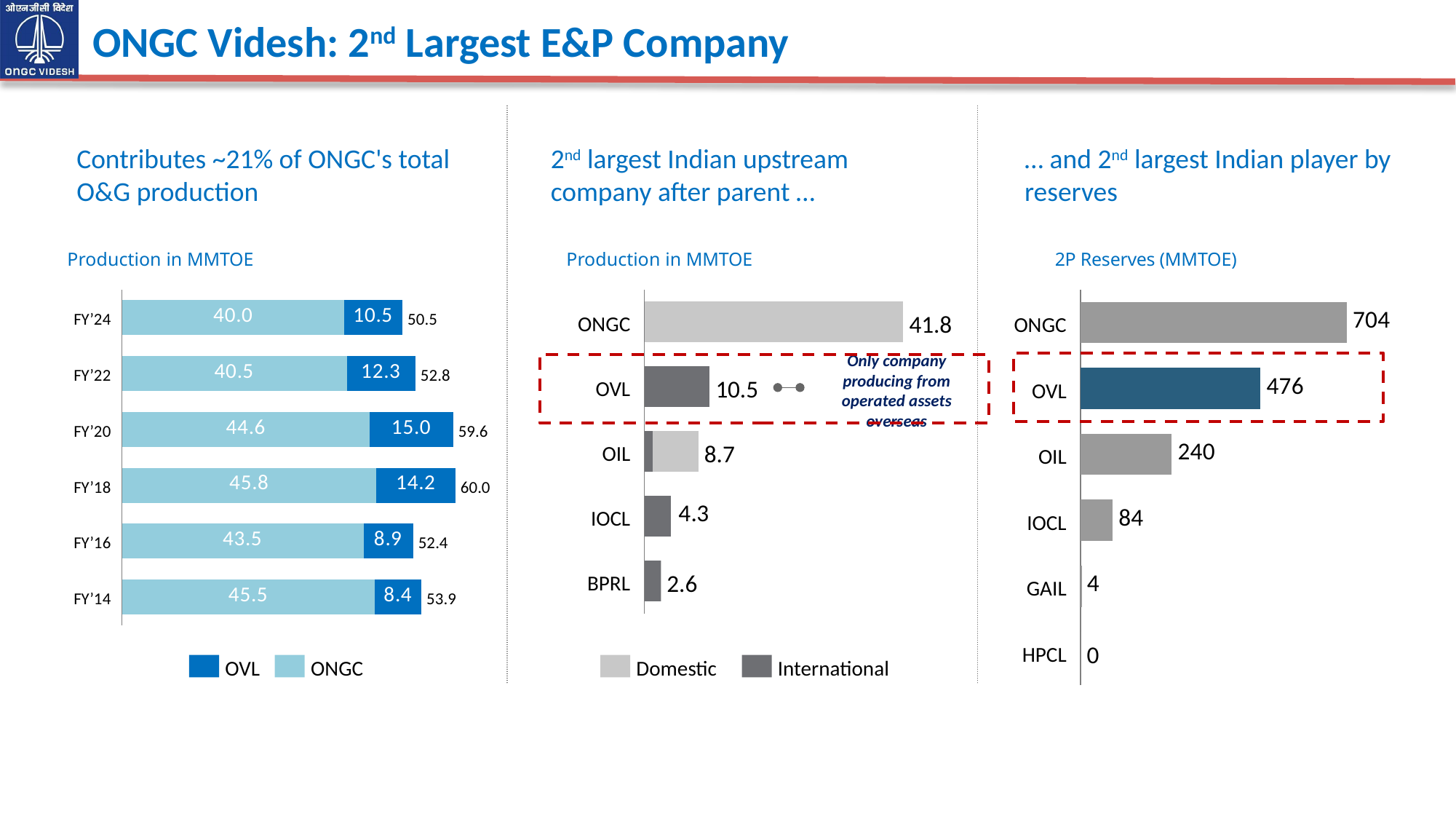
In the right chart (2P Reserves), which is larger, the value for IOCL or the value for GAIL? IOCL In the middle chart (Production in MMTOE by company), what is the difference between ONGC and OVL? 31.3 What kind of chart is the right chart (2P Reserves)? Bar chart In the right chart (2P Reserves), what is the value for OIL? 240 In the left chart (Production in MMTOE by fiscal year), which fiscal year has the highest total production? FY'18 In the left chart (Production in MMTOE by fiscal year), what is the total of the stacked bar for FY'18? 60.0 In the left chart (Production in MMTOE by fiscal year), what is the difference between the ONGC value for FY'14 and the ONGC value for FY'24? 5.5 In the left chart (Production in MMTOE by fiscal year), how many fiscal years are shown? 6 In the left chart (Production in MMTOE by fiscal year), how many series does the legend list? 2 In the left chart (Production in MMTOE by fiscal year), what is the OVL value for FY'20? 15.0 In the middle chart (Production in MMTOE by company), what is the value for IOCL? 4.3 In the middle chart (Production in MMTOE by company), which company has the lowest production? BPRL